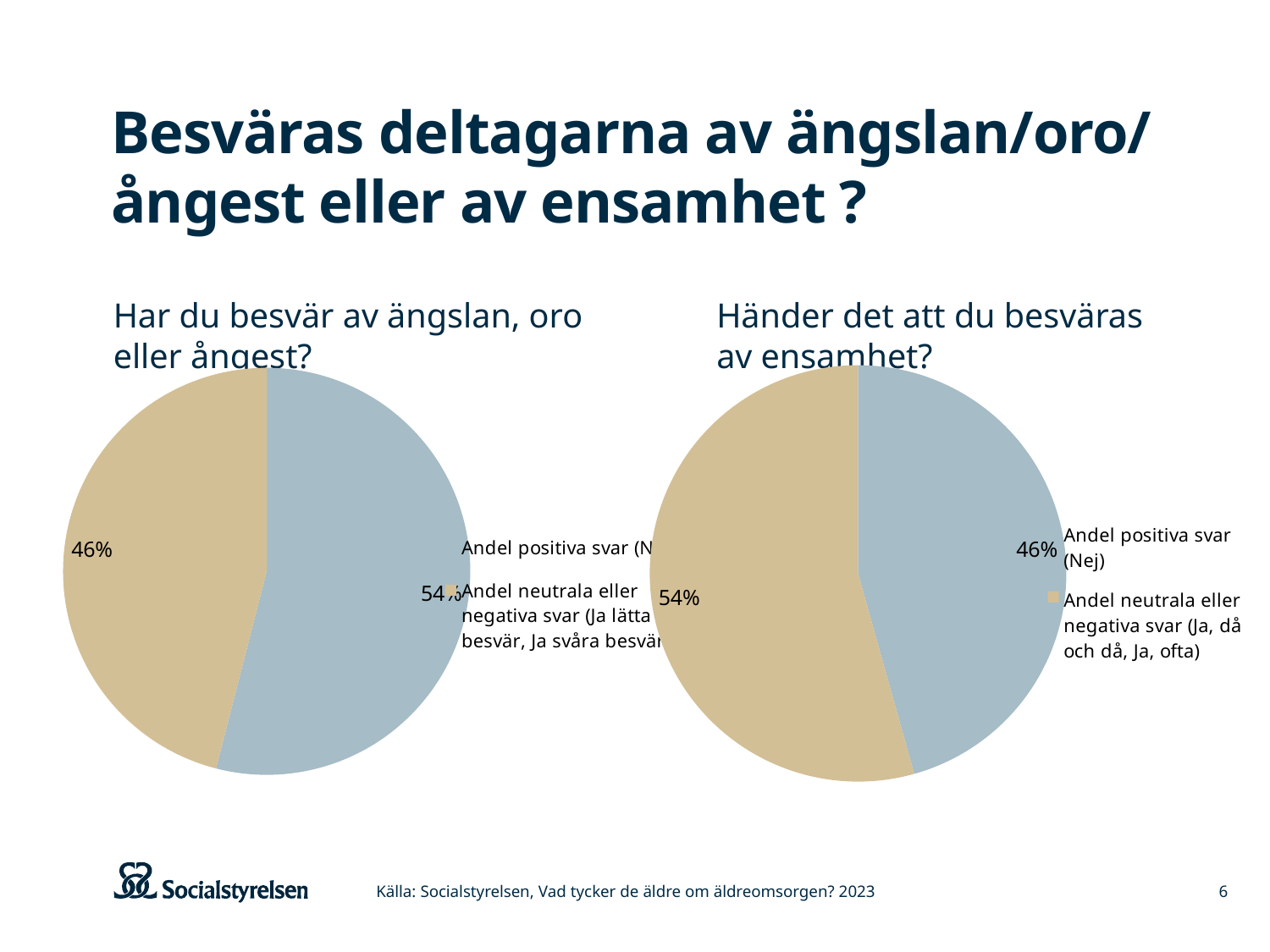
How many charts are shown on the slide? 2 In the chart 'Har du besvär av ängslan, oro eller ångest?', what is the difference in percentage points between the positive and the neutral/negative share? 8 percentage points In the chart 'Händer det att du besväras av ensamhet?', what share of answers are 'Andel positiva svar (Nej)'? 46% How many slices does the chart 'Händer det att du besväras av ensamhet?' have? 2 In the chart 'Händer det att du besväras av ensamhet?', which slice is the smallest? Andel positiva svar (Nej) What type of chart is used on the left side of the slide? Pie chart In the chart 'Har du besvär av ängslan, oro eller ångest?', what share of answers are 'Andel positiva svar (Nej)'? 54% In the chart 'Har du besvär av ängslan, oro eller ångest?', which slice is the largest? Andel positiva svar (Nej) In the chart 'Händer det att du besväras av ensamhet?', which is larger: the positive share or the neutral/negative share? The neutral/negative share (54%) In the chart 'Händer det att du besväras av ensamhet?', what colour is the slice for 'Andel positiva svar (Nej)'? Blue-grey In the chart 'Händer det att du besväras av ensamhet?', what share of answers are 'Andel neutrala eller negativa svar (Ja, då och då, Ja, ofta)'? 54% In the chart 'Har du besvär av ängslan, oro eller ångest?', what share of answers are 'Andel neutrala eller negativa svar'? 46%